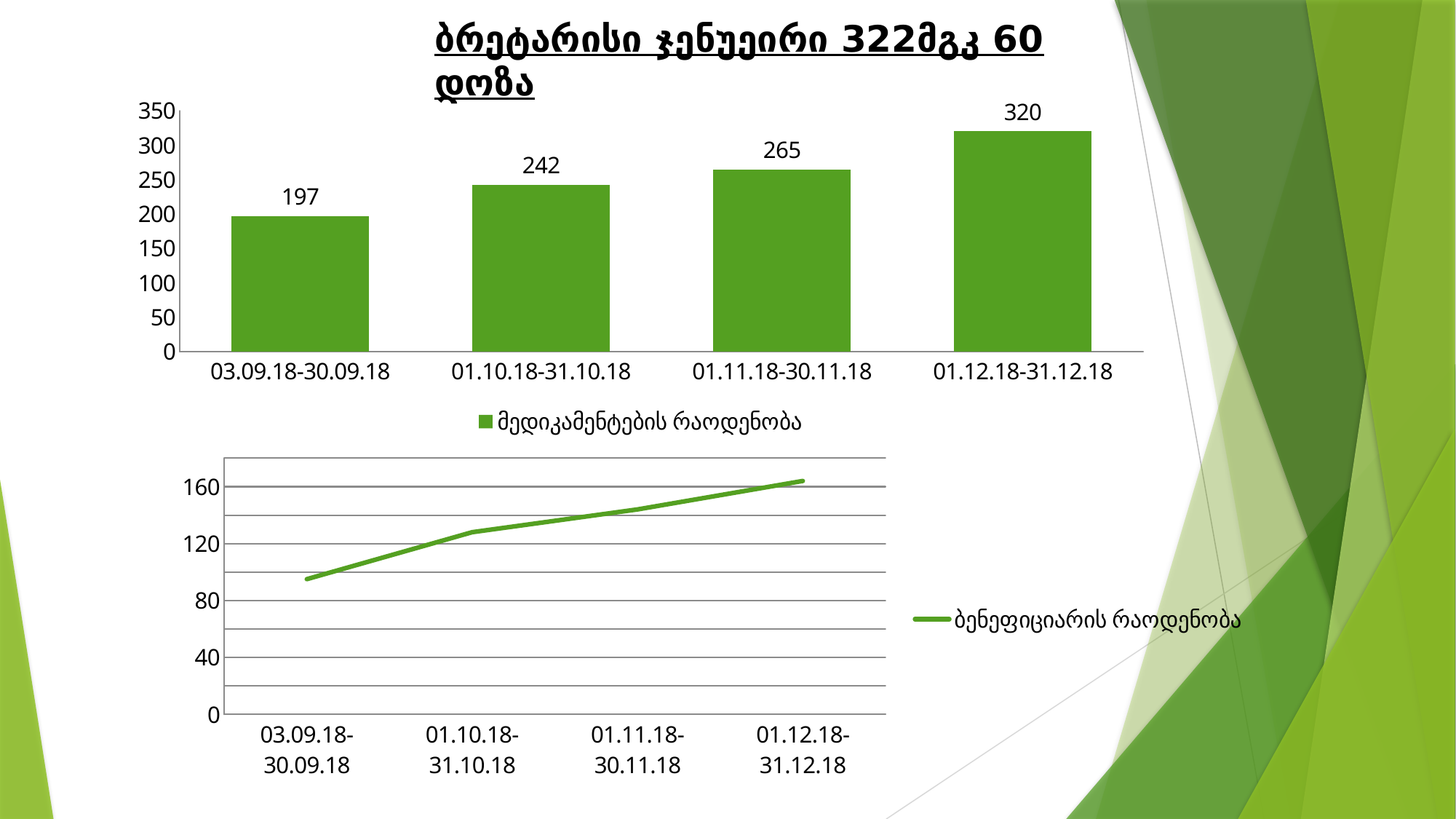
In the top bar chart, which period has the lowest value? 03.09.18-30.09.18 In the bottom line chart, is the value for 01.12.18-31.12.18 greater or less than 120? greater In the top bar chart, how many bars are there? 4 In the top bar chart, which is larger: the value for 01.10.18-31.10.18 or for 01.11.18-30.11.18? 01.11.18-30.11.18 In the top bar chart, what is the value for 03.09.18-30.09.18? 197 What kind of chart is the bottom chart on the slide? line chart In the top bar chart, do the values rise or fall from left to right? rise In the bottom line chart, is the value for 03.09.18-30.09.18 greater or less than 120? less In the top bar chart, which period has the highest value? 01.12.18-31.12.18 In the top bar chart, what is the difference between the values for 01.12.18-31.12.18 and 01.10.18-31.10.18? 78 In the top bar chart, what is the value for 01.11.18-30.11.18? 265 In the top bar chart, what is the value for 01.12.18-31.12.18? 320